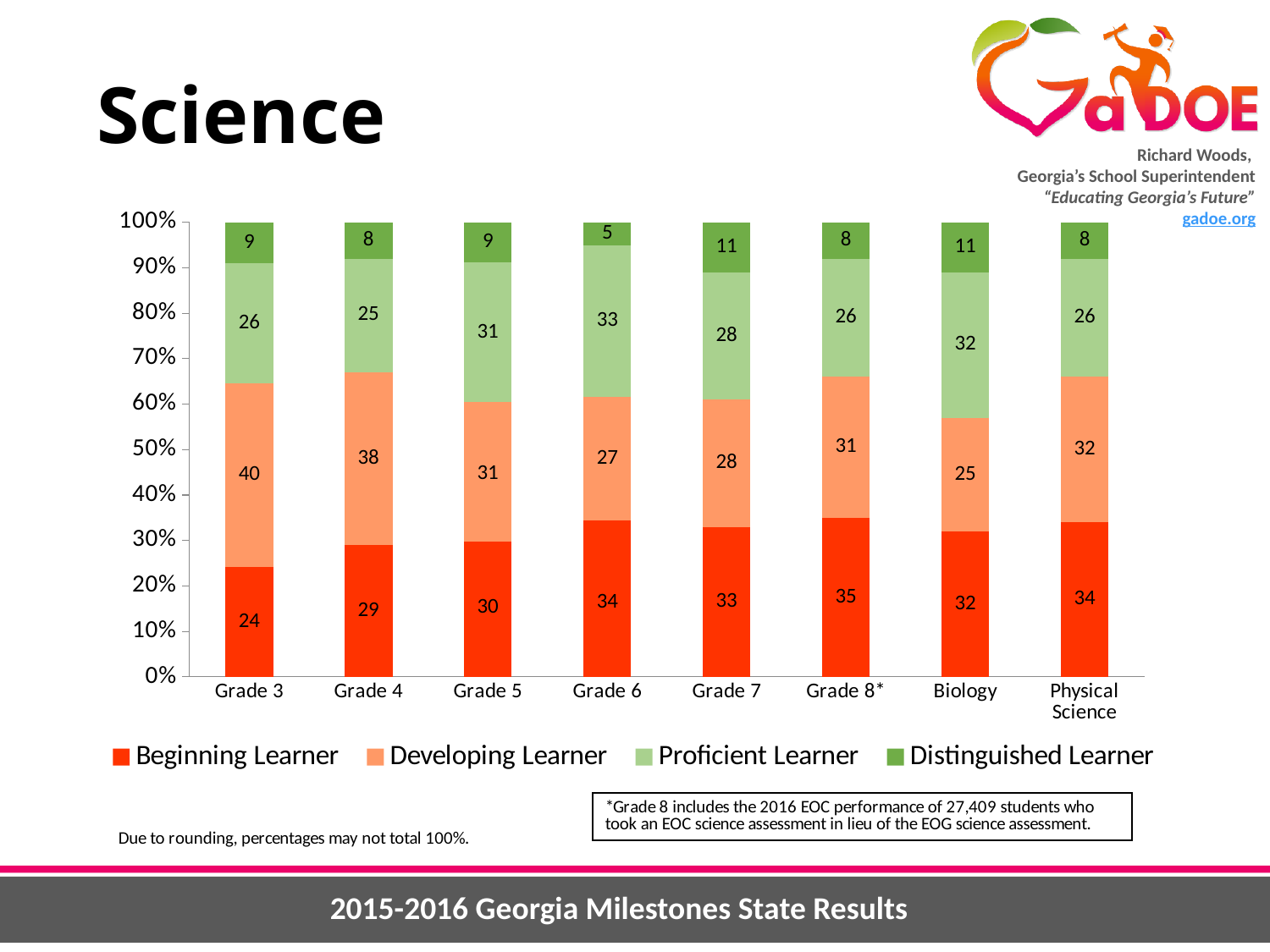
What is the Beginning Learner value for Grade 3? 24 Which category has the lowest Distinguished Learner value? Grade 6 What is the Developing Learner value for Grade 4? 38 Which category has the highest Beginning Learner value? Grade 8* How many series does the legend list? 4 What kind of chart is shown on the slide? Stacked bar chart What is the difference between the Developing Learner values for Grade 3 and Biology? 15 Which legend entry is shown in the darkest green colour? Distinguished Learner What is the Distinguished Learner value for Grade 6? 5 Which is larger, the Proficient Learner value for Grade 6 or for Grade 7? Grade 6 What is the Proficient Learner value for Biology? 32 How many categories are shown on the x axis? 8